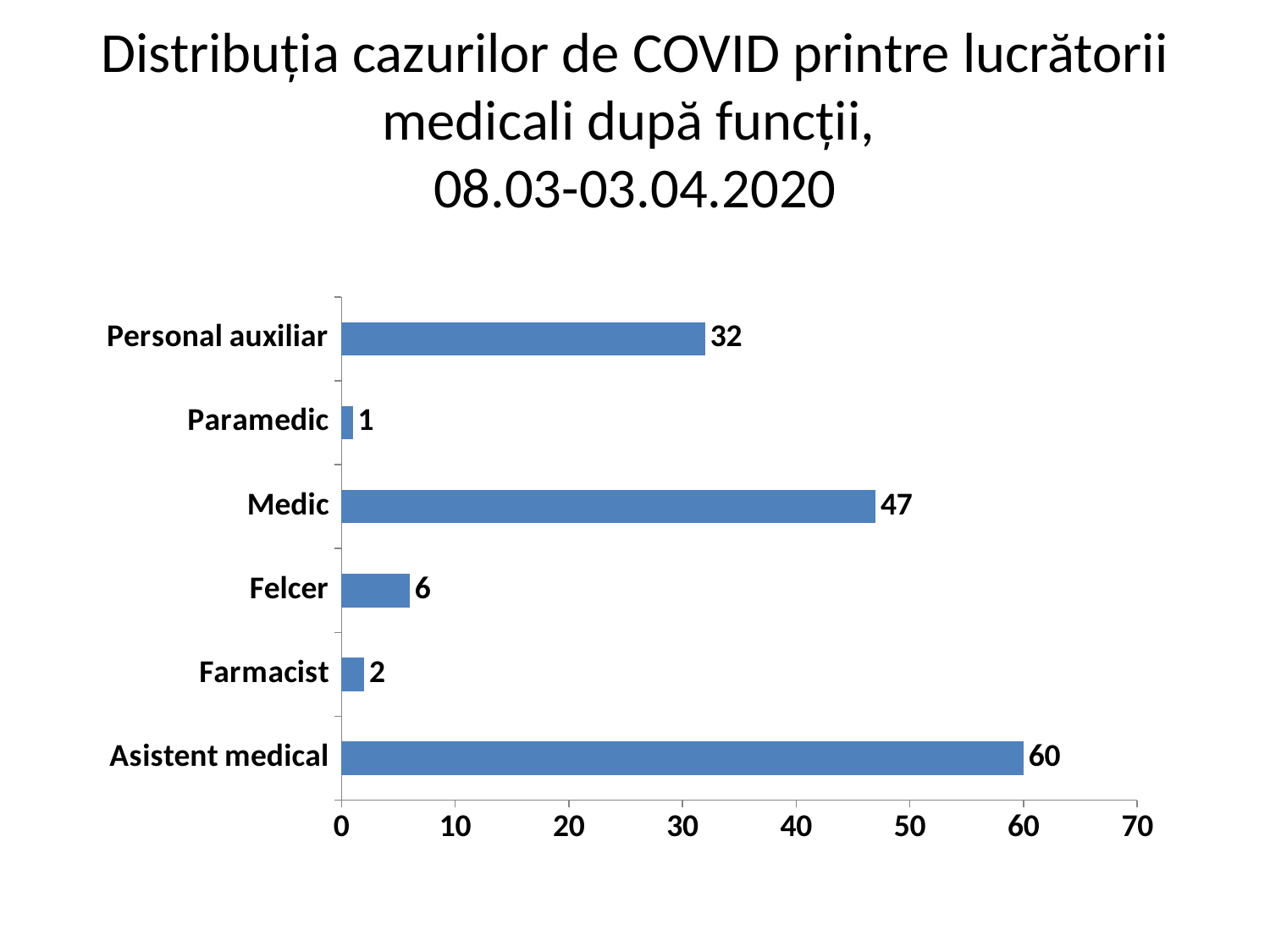
How many categories are shown in the chart? 6 Which category has the lowest value? Paramedic What kind of chart is shown on the slide? Bar chart What is the difference between the values for Personal auxiliar and Felcer? 26 What is the value for Felcer? 6 What is the value for Asistent medical? 60 What is the value for Personal auxiliar? 32 Which category has the highest value? Asistent medical Which is larger, the value for Farmacist or the value for Felcer? Felcer What is the difference between the values for Asistent medical and Medic? 13 What is the value for Medic? 47 What is the title of the chart on the slide? Distribuția cazurilor de COVID printre lucrătorii medicali după funcții, 08.03-03.04.2020